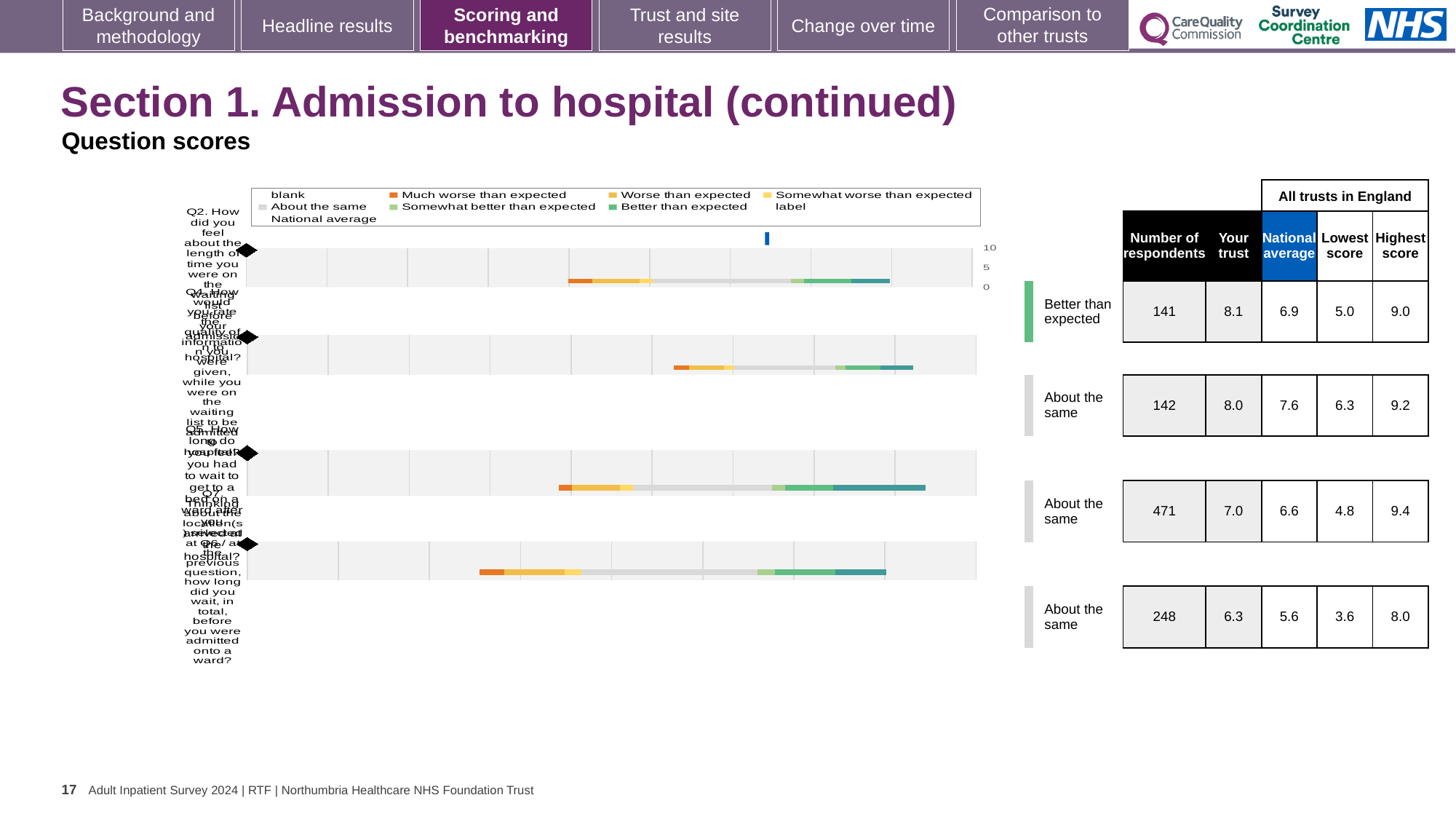
How many question bars are plotted in the chart? 4 What is the highest score across all trusts in England for the third question row? 9.4 What is the 'Your trust' score for the first (top) question row? 8.1 How many respondents are shown for the third question row? 471 For the first question row, how much higher is the 'Your trust' score than the national average? 1.2 Which question row has the lowest 'Your trust' score? the fourth (bottom) row, 6.3 What is the national average for the second question row? 7.6 What benchmark rating is given to the first (top) question row? Better than expected Which question row has the highest 'Your trust' score? the first (top) row, 8.1 For the third question row, which is larger: the 'Your trust' score or the national average? Your trust (7.0) What kind of chart is shown on the slide? bar chart How many entries does the chart legend list? 9